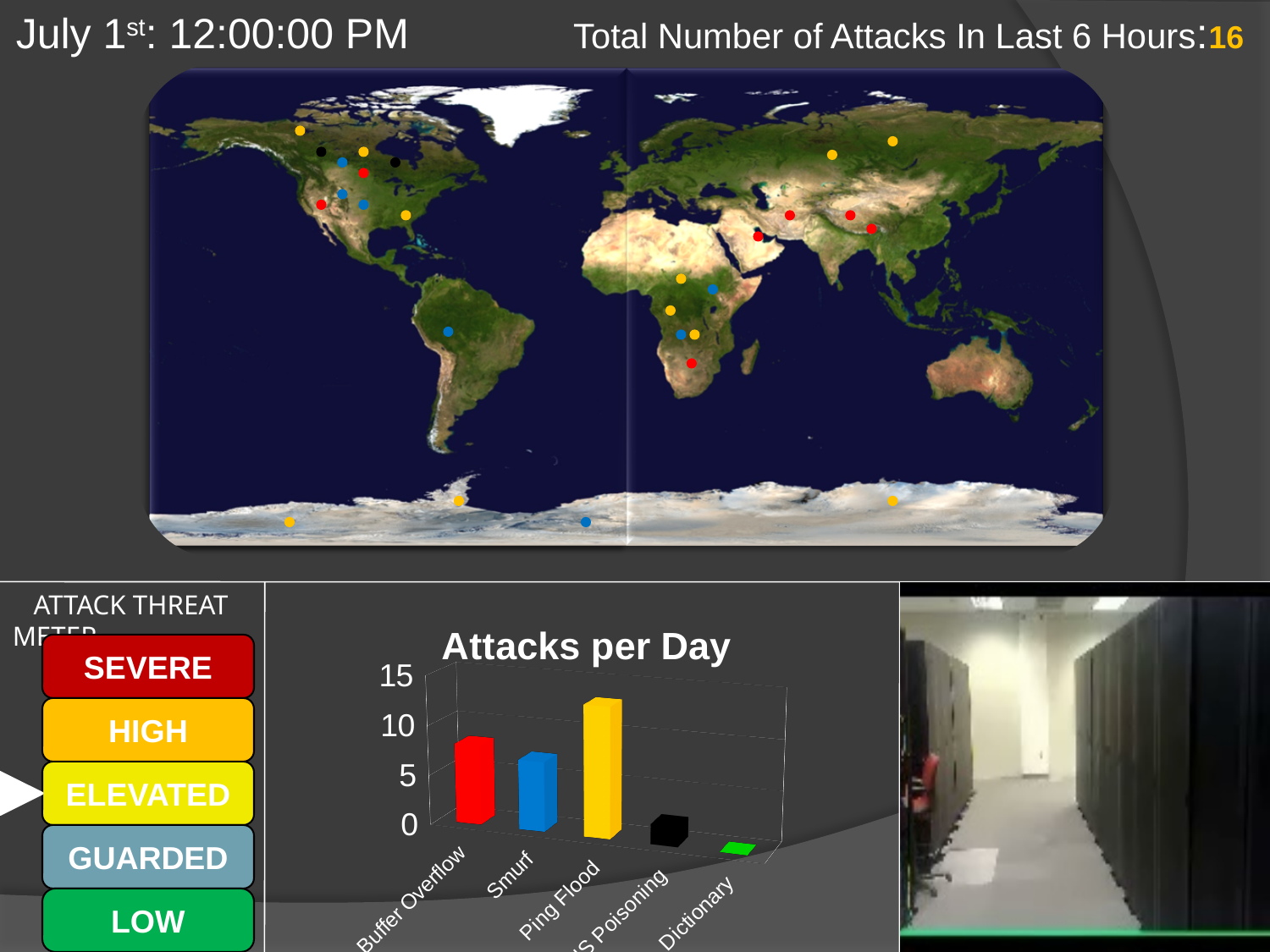
Which category has the highest value in the "Attacks per Day" chart? Ping Flood In the "Attacks per Day" chart, which is larger, Ping Flood or Buffer Overflow? Ping Flood What kind of chart is the "Attacks per Day" chart? bar chart How many categories are shown on the x axis of the "Attacks per Day" chart? 5 In the "Attacks per Day" chart, which is larger, Buffer Overflow or Smurf? Buffer Overflow In the "Attacks per Day" chart, is the value for Buffer Overflow greater or less than 10? less What is the title of the chart on the slide? Attacks per Day In the "Attacks per Day" chart, is the value for Buffer Overflow greater or less than 5? greater Which category has the lowest value in the "Attacks per Day" chart? Dictionary In the "Attacks per Day" chart, is the value for Dictionary greater or less than 5? less What colour is the Ping Flood bar in the "Attacks per Day" chart? yellow